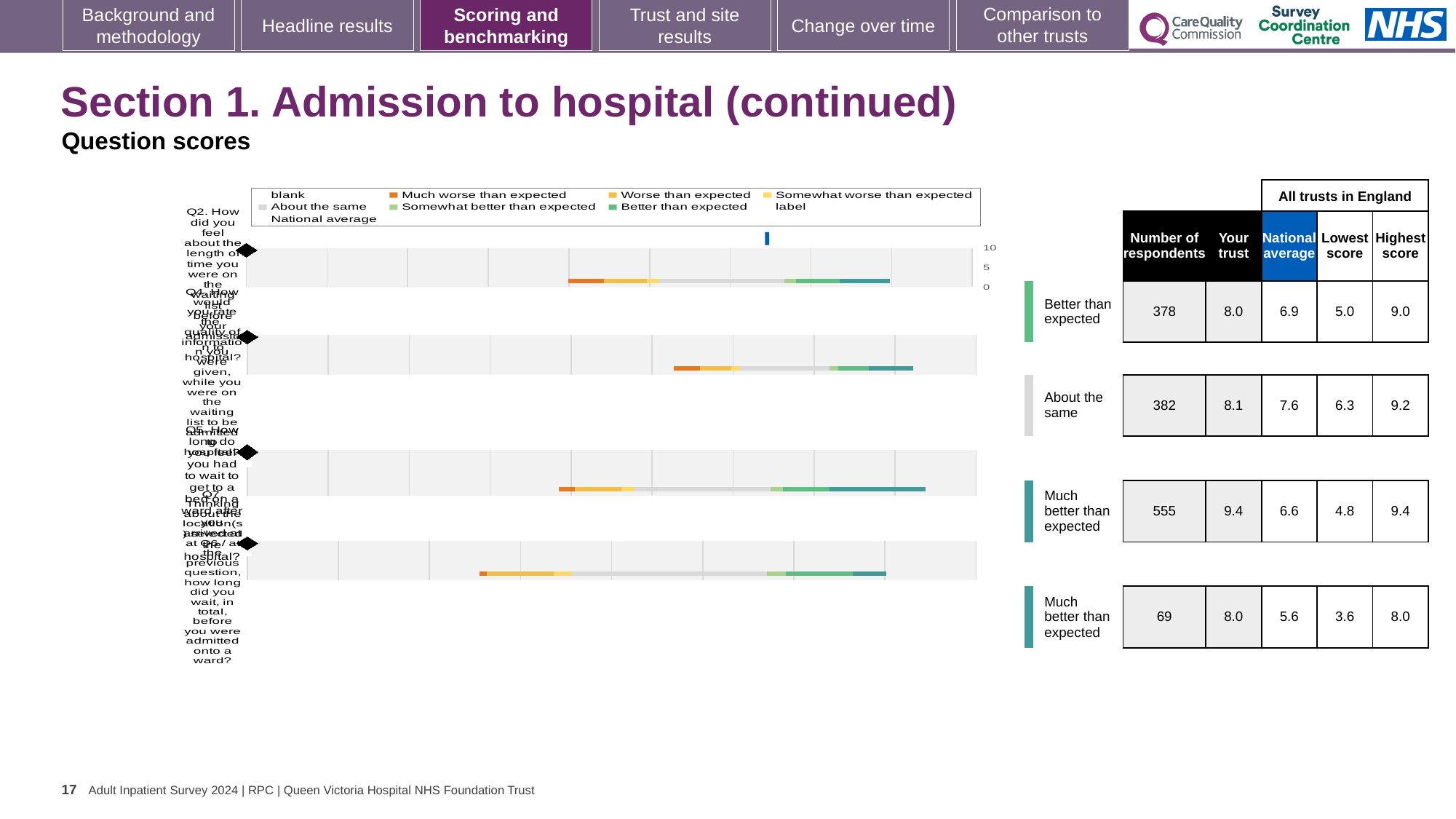
Which row has the lowest number of respondents in the table beside the chart? the last row (69) For the row with 382 respondents, which is larger: the 'Your trust' score or the national average? Your trust In the table beside the chart, what is the highest score for the row with 555 respondents? 9.4 How many question rows (bars) does the chart show? 4 For the row with 555 respondents, what is the difference between the 'Your trust' score and the national average? 2.8 In the table beside the chart, what is the lowest score for the last row (69 respondents)? 3.6 In the table beside the chart, what is the 'Your trust' score for the first row (378 respondents)? 8.0 What is the highest tick value shown on the chart's score axis? 10 What colour does the legend use for 'Much worse than expected'? orange In the table beside the chart, what is the national average for the row with 382 respondents? 7.6 Which row has the highest 'Your trust' score in the table beside the chart? the row with 555 respondents (9.4) What kind of chart is shown on the slide? bar chart